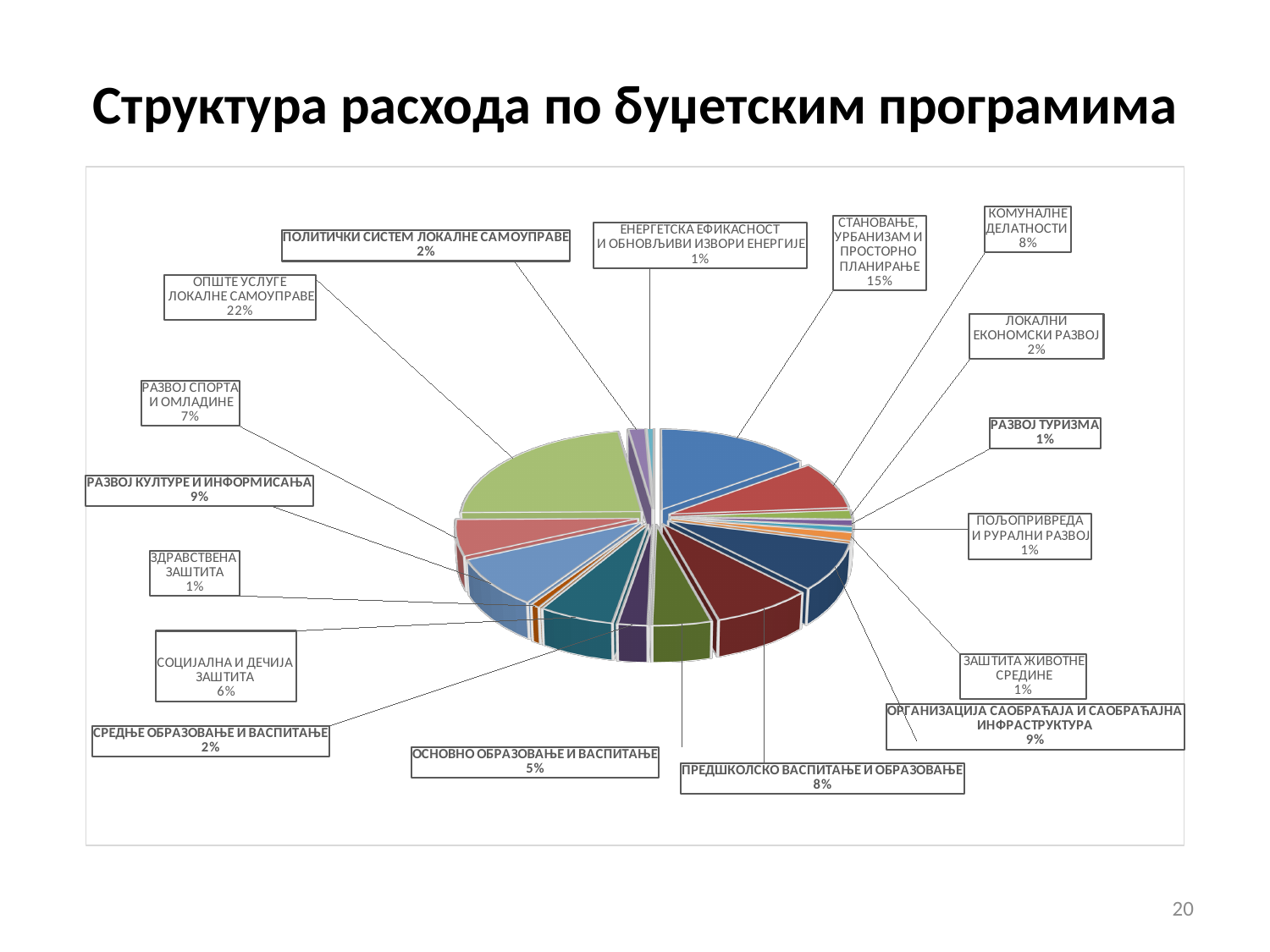
Which has a larger share, РАЗВОЈ КУЛТУРЕ И ИНФОРМИСАЊА or РАЗВОЈ СПОРТА И ОМЛАДИНЕ? РАЗВОЈ КУЛТУРЕ И ИНФОРМИСАЊА What is the difference in percentage points between ОПШТЕ УСЛУГЕ ЛОКАЛНЕ САМОУПРАВЕ and СТАНОВАЊЕ, УРБАНИЗАМ И ПРОСТОРНО ПЛАНИРАЊЕ? 7 What share does СТАНОВАЊЕ, УРБАНИЗАМ И ПРОСТОРНО ПЛАНИРАЊЕ have in the pie chart? 15% What is the title of the slide? Структура расхода по буџетским програмима What share does СОЦИЈАЛНА И ДЕЧИЈА ЗАШТИТА have in the pie chart? 6% What share does ОПШТЕ УСЛУГЕ ЛОКАЛНЕ САМОУПРАВЕ have in the pie chart? 22% What kind of chart is shown on the slide? pie chart Which category has the largest share in the pie chart? ОПШТЕ УСЛУГЕ ЛОКАЛНЕ САМОУПРАВЕ What share does РАЗВОЈ СПОРТА И ОМЛАДИНЕ have in the pie chart? 7% What share does КОМУНАЛНЕ ДЕЛАТНОСТИ have in the pie chart? 8% What share does ОСНОВНО ОБРАЗОВАЊЕ И ВАСПИТАЊЕ have in the pie chart? 5% How many categories are shown in the pie chart? 17